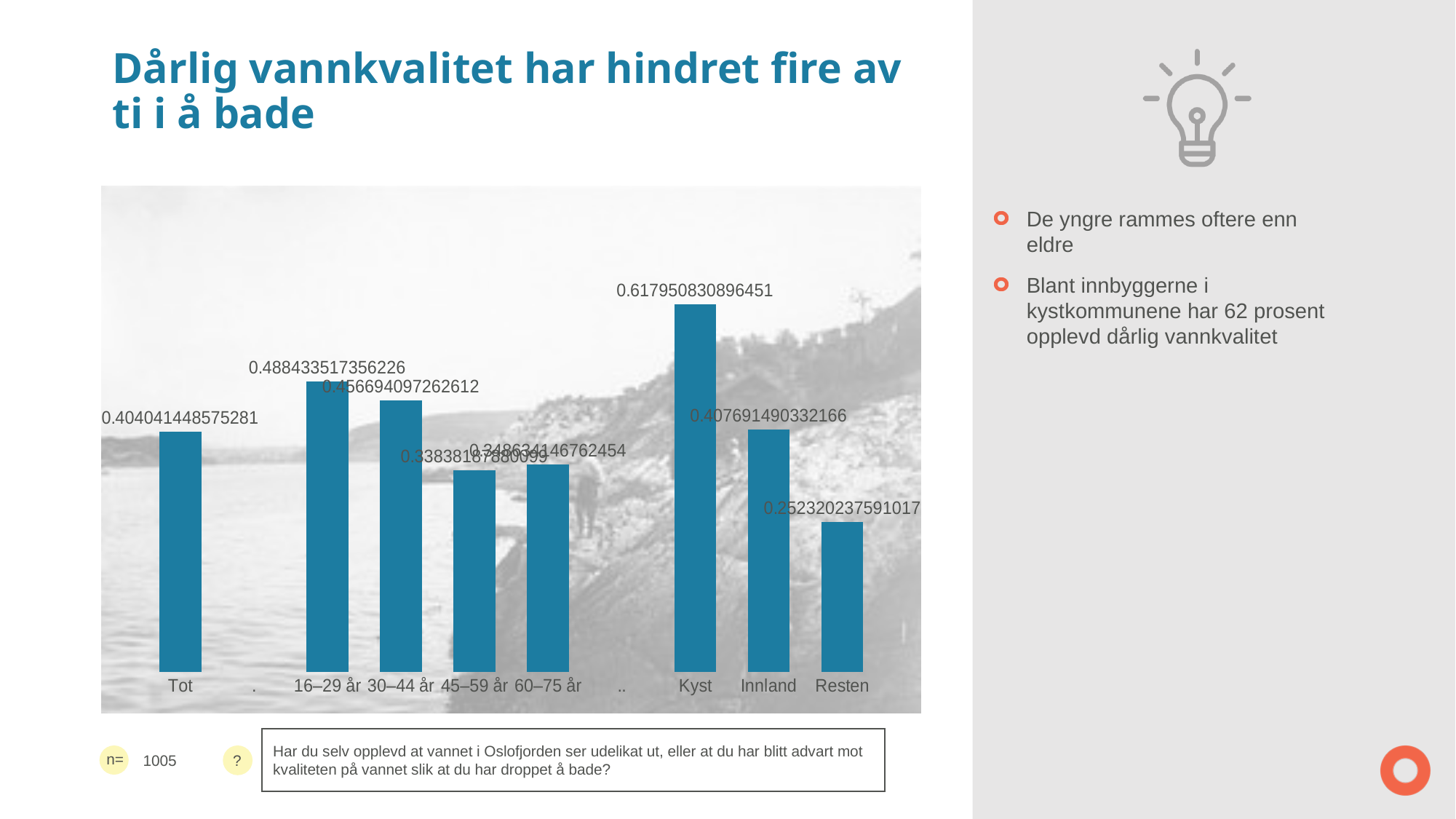
Which is larger, the value for Kyst or the value for Innland? Kyst What is the difference between the values for 16–29 år and 30–44 år? 0.031739420093614 How many bars are plotted in the chart? 8 Which category has the highest value? Kyst What is the value for Kyst? 0.617950830896451 Which is larger, the value for 16–29 år or the value for 60–75 år? 16–29 år Which category has the lowest value? Resten What is the value for Tot? 0.404041448575281 What type of chart is shown on the slide? bar chart What is the value for Innland? 0.407691490332166 What is the value for Resten? 0.252320237591017 What is the value for 16–29 år? 0.488433517356226